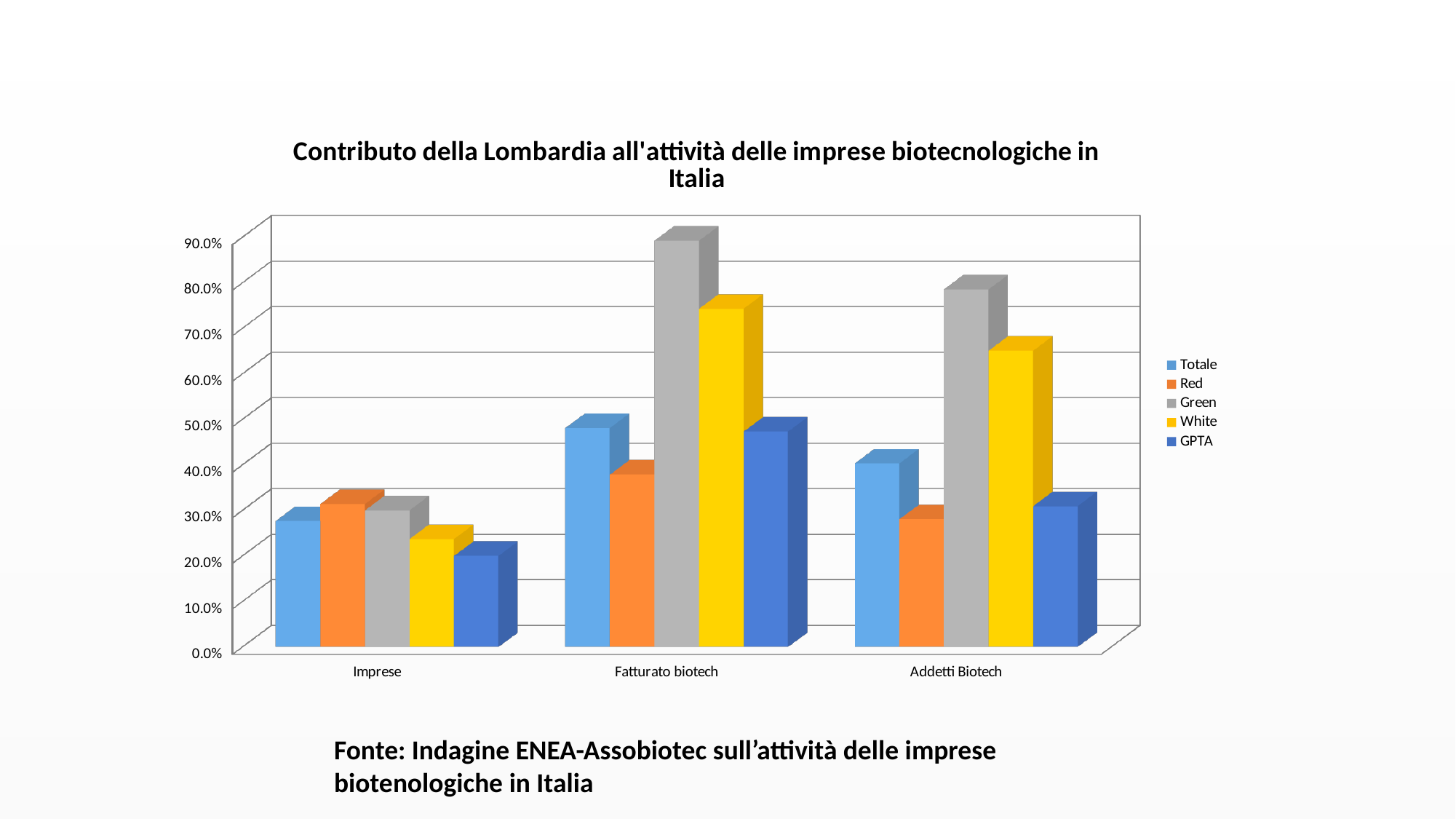
How many categories are shown on the x axis? 3 What kind of chart is shown on the slide? bar chart Which series has the lowest value for Imprese? GPTA Is the value for Red in Addetti Biotech greater or less than 40.0%? less Is the value for Green in Fatturato biotech greater or less than 80.0%? greater For Addetti Biotech, which is larger: Green or White? Green Which series has the highest value for Fatturato biotech? Green In which category does the Green series reach its highest value? Fatturato biotech Is the value for GPTA in Imprese greater or less than 30.0%? less What is the title of the chart? Contributo della Lombardia all'attività delle imprese biotecnologiche in Italia How many series does the legend list? 5